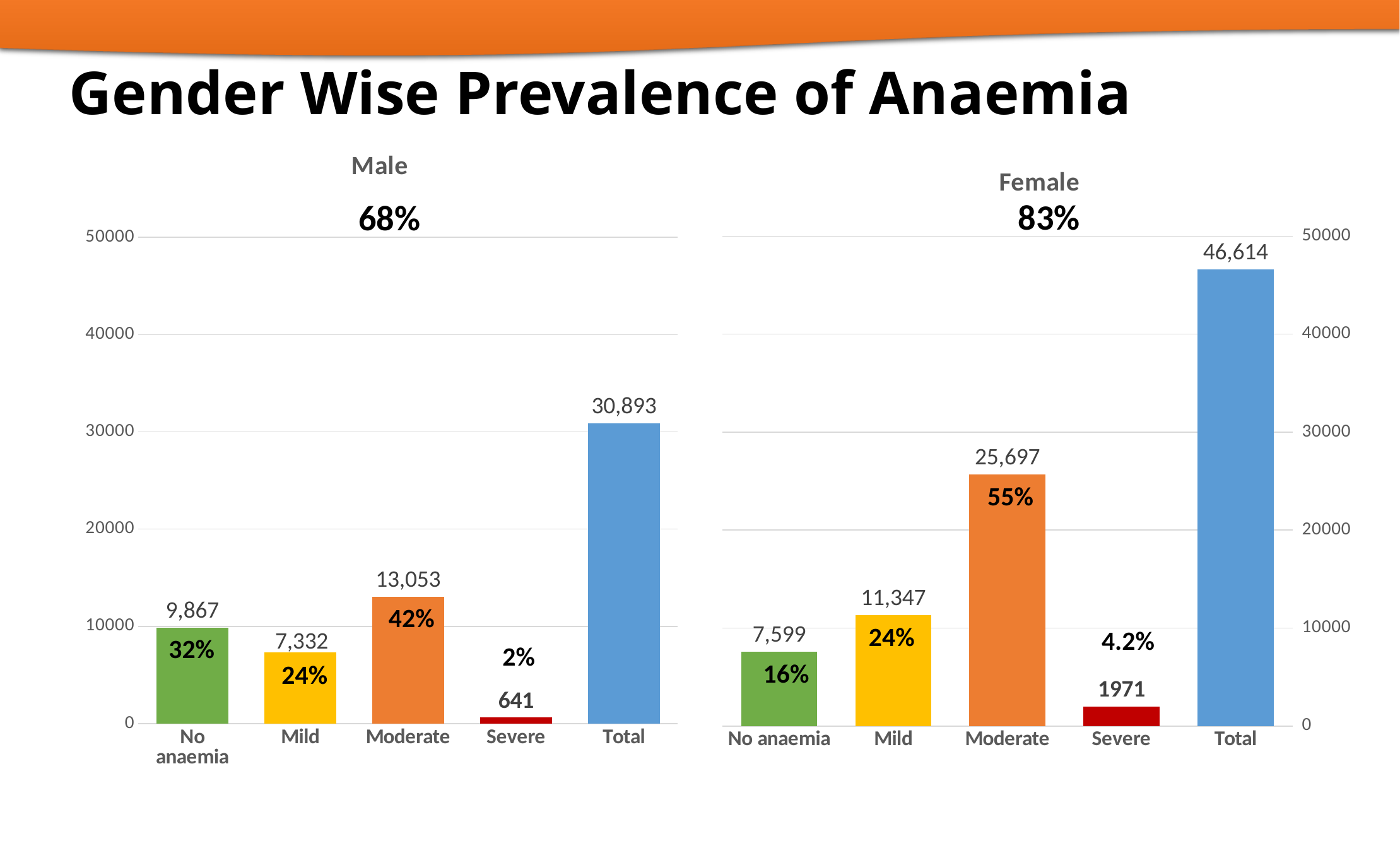
Which is larger: Mild in the Male chart or Mild in the Female chart? Mild in the Female chart How many categories are shown on the x axis of the Female chart? 5 In the Female chart, what is the difference between Moderate and Mild? 14,350 What kind of chart is the Male chart? bar chart In the Male chart, what is the difference between No anaemia and Mild? 2,535 In the Male chart, excluding Total, which category has the highest value? Moderate In the Male chart, what is the value for Moderate? 13,053 In the Male chart, is the value for Total greater or less than 30000? greater In the Female chart, what is the value for Total? 46,614 In the Male chart, what is the value for No anaemia? 9,867 In the Female chart, which category has the lowest value? Severe In the Female chart, what is the value for Severe? 1971